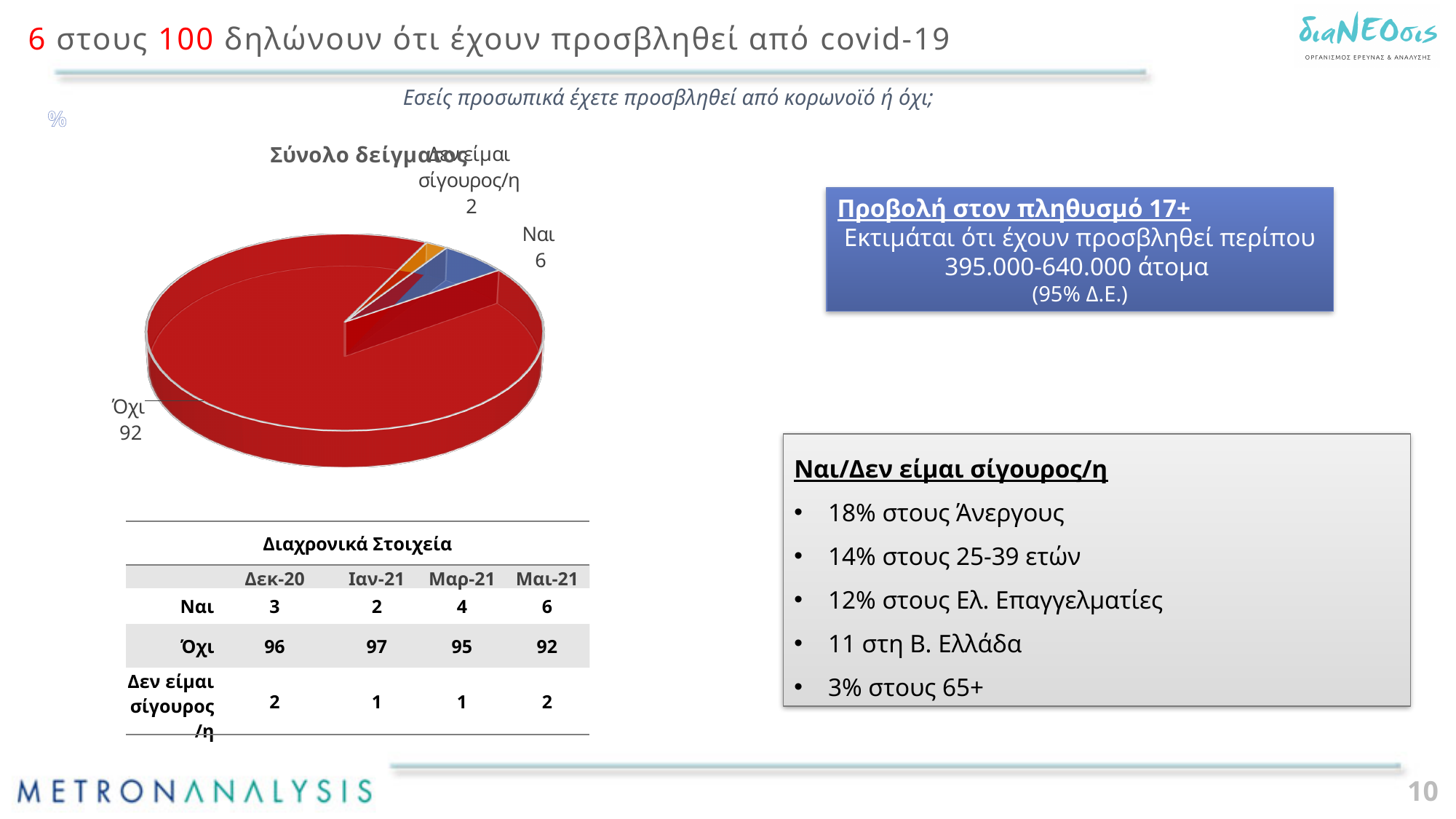
How many slices does the pie chart have? 3 What kind of chart is shown on the slide? pie chart What is the difference between the "Ναι" and "Δεν είμαι σίγουρος/η" values in the pie chart? 4 What colour is the "Όχι" slice of the pie chart? red Which slice of the pie chart is the largest? Όχι What is the title of the pie chart? Σύνολο δείγματος Which slice of the pie chart is the smallest? Δεν είμαι σίγουρος/η What is the value for the "Ναι" slice of the pie chart? 6 What is the value for the "Δεν είμαι σίγουρος/η" slice of the pie chart? 2 Which is larger in the pie chart, "Ναι" or "Δεν είμαι σίγουρος/η"? Ναι What is the difference between the "Όχι" and "Ναι" values in the pie chart? 86 What is the value for the "Όχι" slice of the pie chart? 92